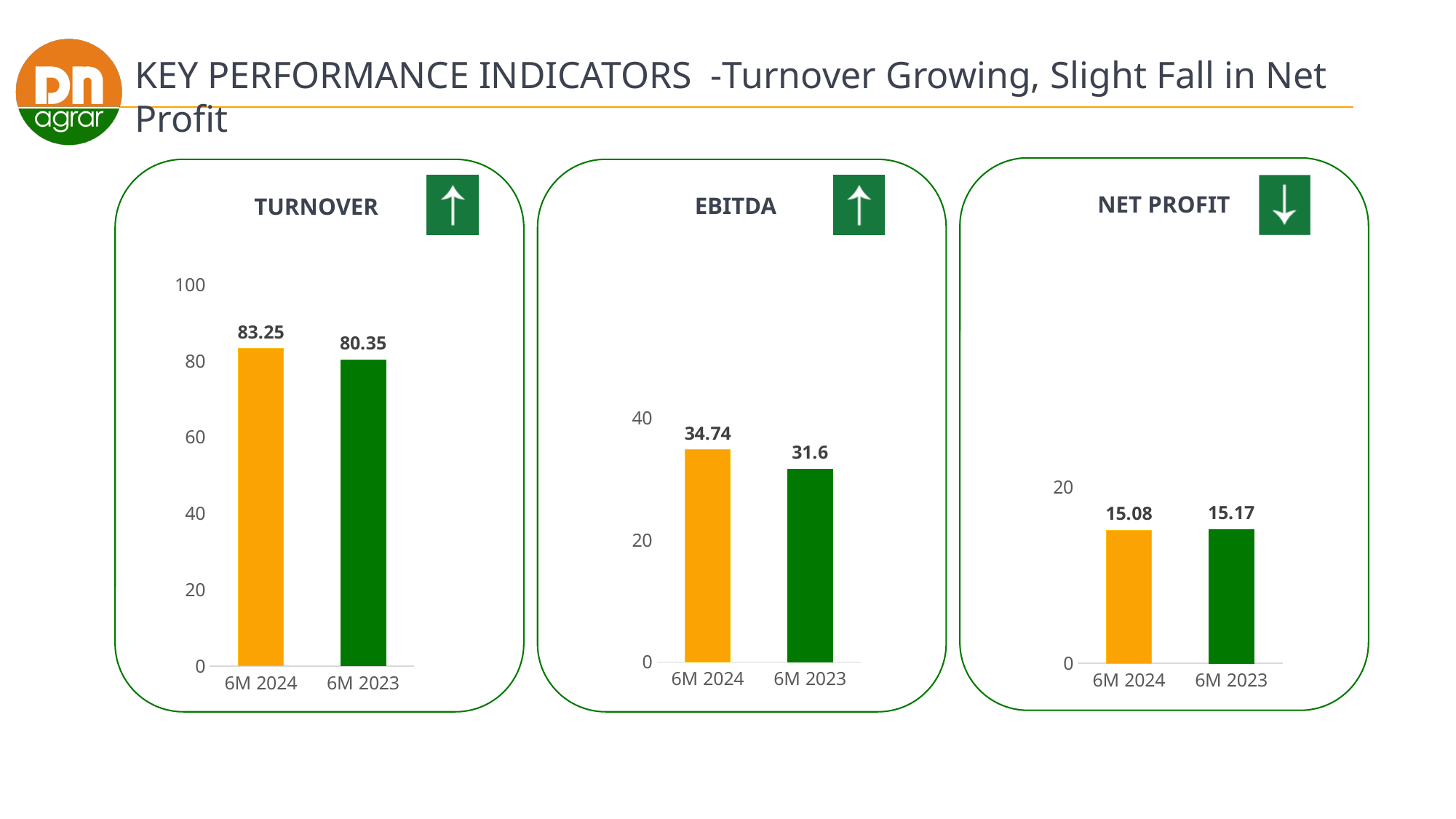
In the EBITDA chart, what is the value for 6M 2024? 34.74 In the NET PROFIT chart, what is the value for 6M 2024? 15.08 In the TURNOVER chart, what is the value for 6M 2024? 83.25 In the EBITDA chart, what is the value for 6M 2023? 31.6 In the TURNOVER chart, is the value for 6M 2023 greater or less than 60? greater In the EBITDA chart, which period has the higher value, 6M 2024 or 6M 2023? 6M 2024 In the NET PROFIT chart, what is the difference between the 6M 2023 and 6M 2024 values? 0.09 In the EBITDA chart, what is the difference between the 6M 2024 and 6M 2023 values? 3.14 In the TURNOVER chart, what is the value for 6M 2023? 80.35 In the TURNOVER chart, what is the difference between the 6M 2024 and 6M 2023 values? 2.9 In the NET PROFIT chart, what is the value for 6M 2023? 15.17 What kind of chart is the NET PROFIT chart? Bar chart